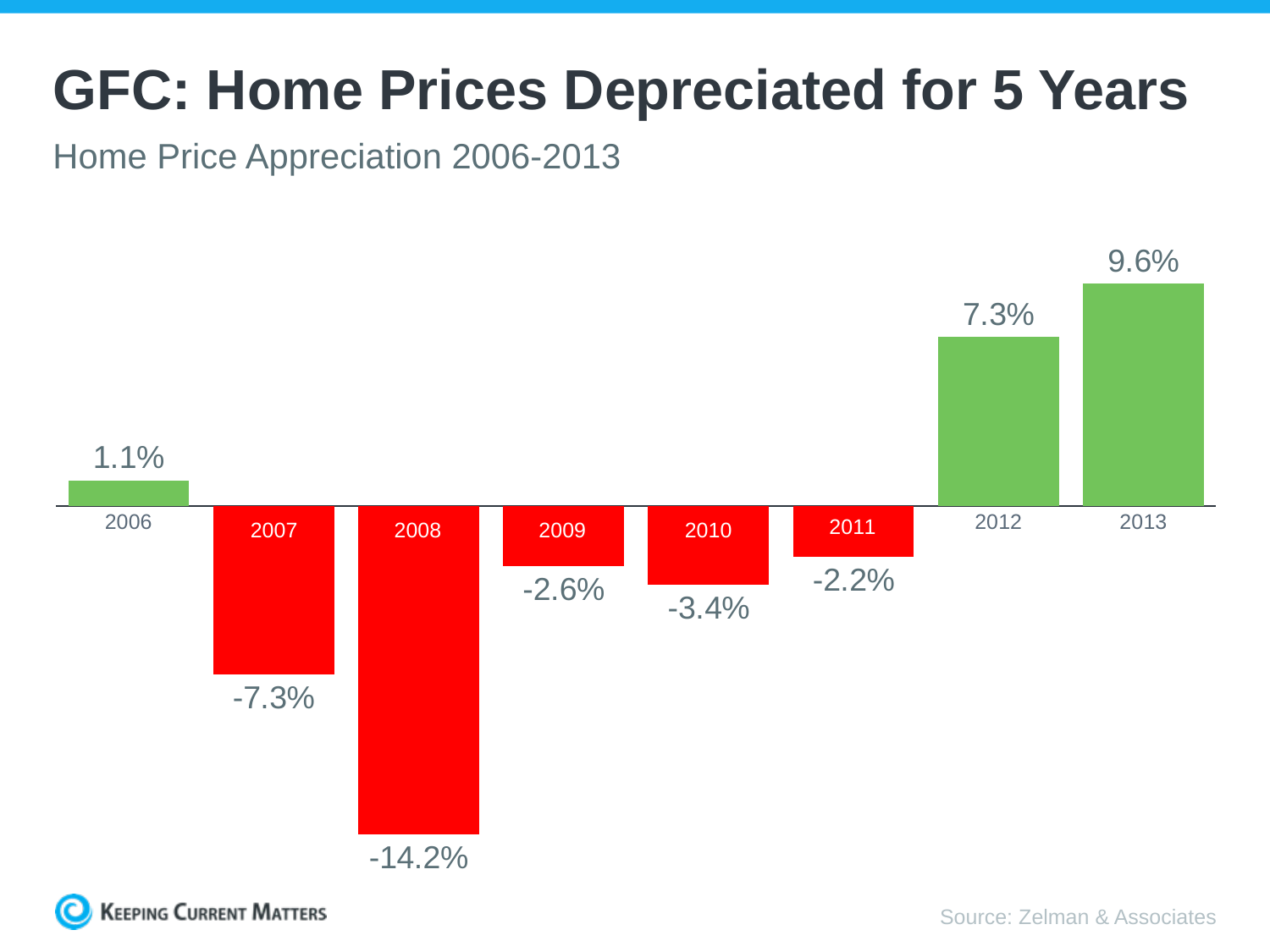
What is the home price appreciation value for 2008? -14.2% Which year has the lowest home price appreciation? 2008 How many years are shown in the chart? 8 What colour are the bars for years with negative values? Red What is the home price appreciation value for 2013? 9.6% What is the difference between the values for 2007 and 2008? 6.9% Which year has the highest home price appreciation? 2013 What is the difference between the values for 2013 and 2012? 2.3% Which year has the larger value, 2009 or 2011? 2011 What is the home price appreciation value for 2010? -3.4% What kind of chart is shown on the slide? Bar chart How many years show negative home price appreciation? 5